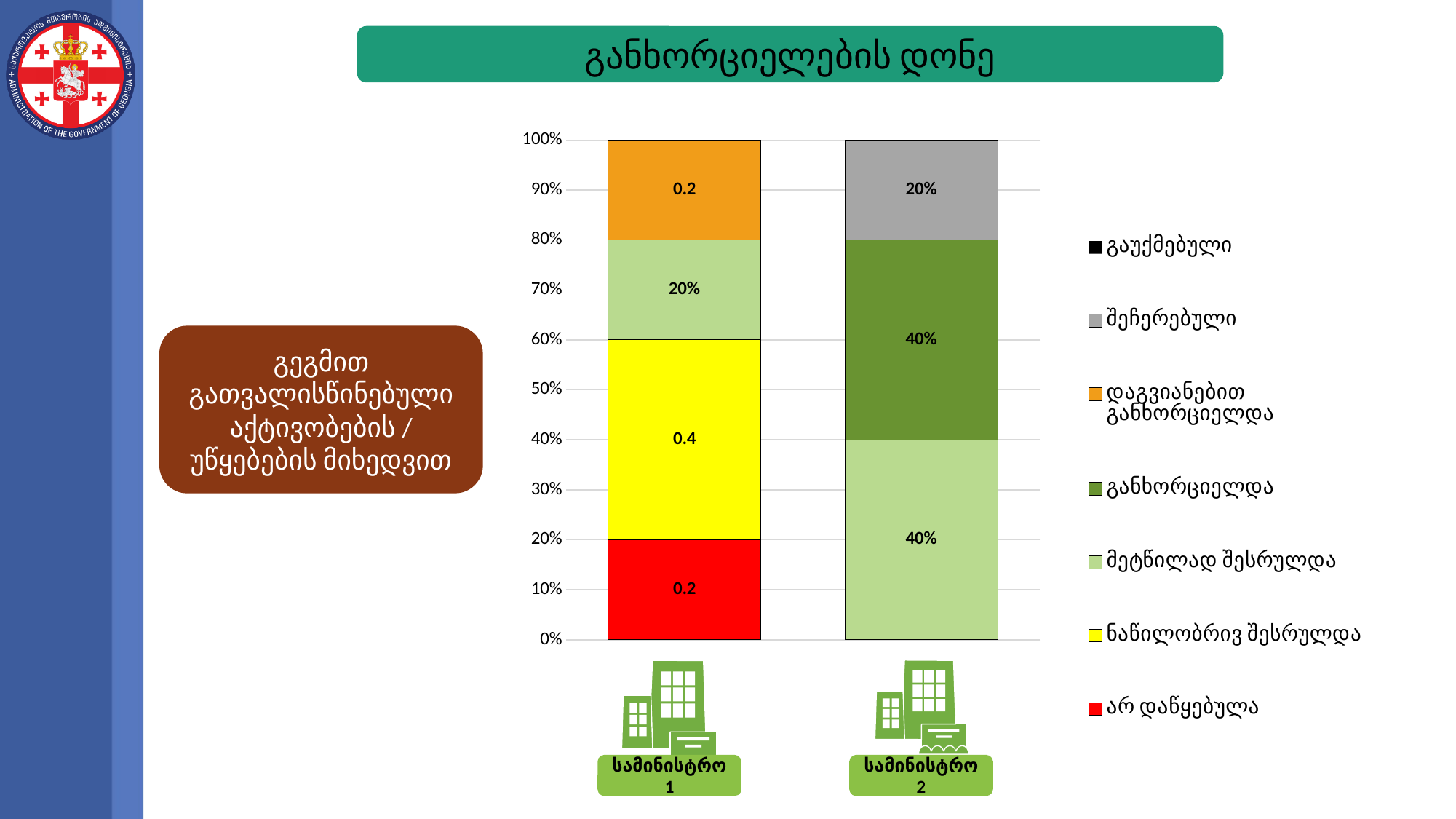
What type of chart is shown on the slide? Stacked bar chart How many entries does the chart legend list? 7 What is the data label for the არ დაწყებულა (red) segment of სამინისტრო 1? 0.2 What is the data label for the ნაწილობრივ შესრულდა (yellow) segment of სამინისტრო 1? 0.4 Which segment is the largest in the სამინისტრო 1 bar? ნაწილობრივ შესრულდა Which legend entry is shown in red? არ დაწყებულა What is the data label for the შეჩერებული (gray) segment of სამინისტრო 2? 20% What is the data label for the განხორციელდა (dark green) segment of სამინისტრო 2? 40% What is the data label for the მეტწილად შესრულდა (light green) segment of სამინისტრო 1? 20% What is the title of the chart? განხორციელების დონე How many categories (bars) are shown on the x axis? 2 What is the data label for the დაგვიანებით განხორციელდა (orange) segment of სამინისტრო 1? 0.2